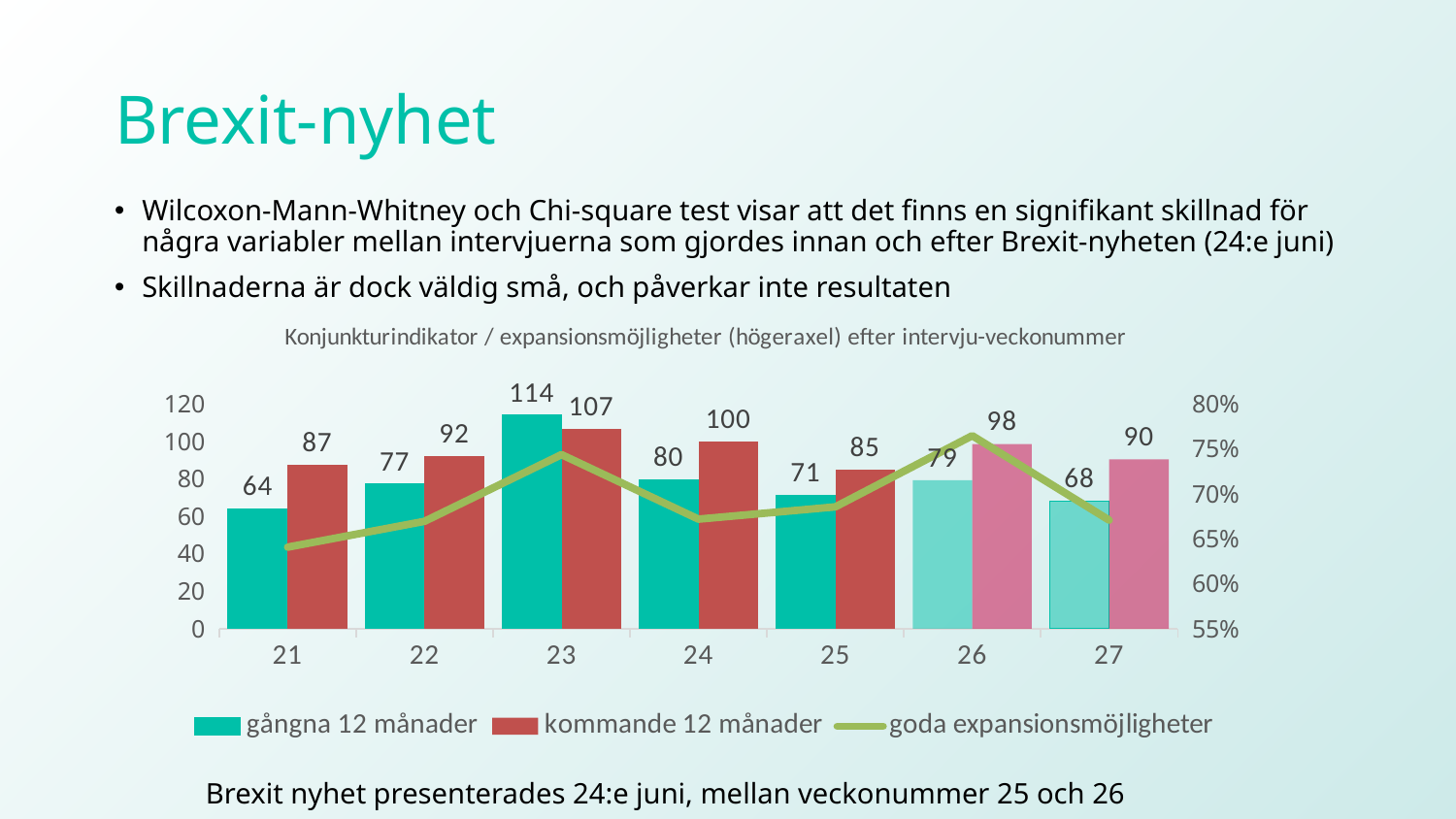
In week 24, which is larger: 'gångna 12 månader' or 'kommande 12 månader'? kommande 12 månader How many series does the legend list? 3 What is the value for 'kommande 12 månader' in week 26? 98 What is the value for 'gångna 12 månader' in week 23? 114 Which week has the highest value for 'kommande 12 månader'? 23 What is the difference between 'kommande 12 månader' and 'gångna 12 månader' in week 27? 22 Is the value of 'goda expansionsmöjligheter' in week 21 greater or less than 70%? less Is the value of 'goda expansionsmöjligheter' in week 26 greater or less than 75%? greater Which week has the lowest value for 'gångna 12 månader'? 21 What is the title of the chart? Konjunkturindikator / expansionsmöjligheter (högeraxel) efter intervju-veckonummer What is the value for 'gångna 12 månader' in week 21? 64 How many weeks are shown on the x axis? 7